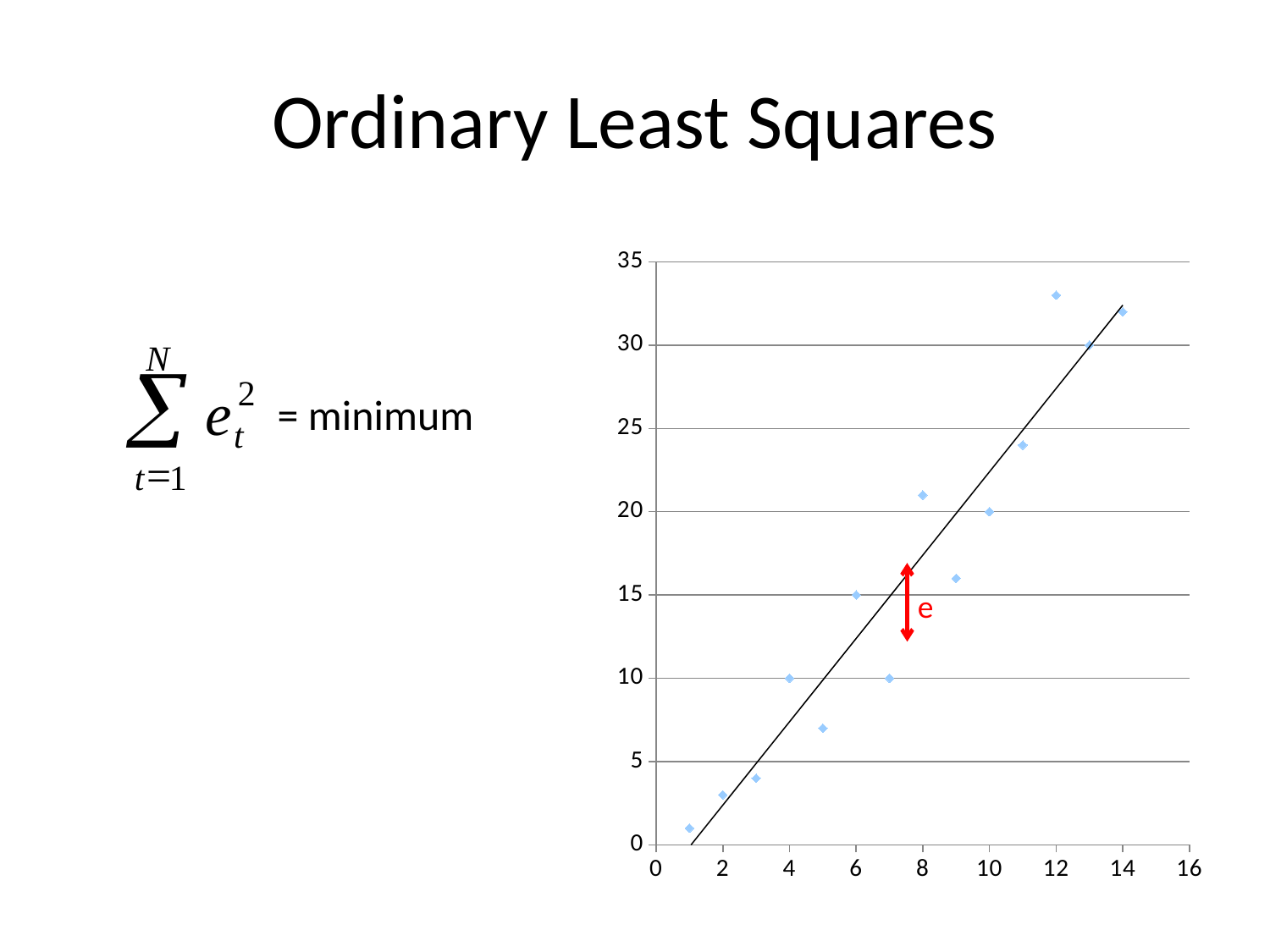
Is the y value of the point at x = 8 greater or less than 20? greater What kind of chart is shown on the slide? scatter chart What is the y value of the point at x = 10? 20 What is the y value of the point at x = 6? 15 What letter labels the red double-headed arrow on the chart? e Is the y value of the point at x = 5 greater or less than 10? less Which x value has the lowest plotted y value? 1 Which point has the larger y value, the one at x = 4 or the one at x = 5? x = 4 How many data points are plotted in the chart? 14 Do the plotted values generally rise or fall as x increases? rise What is the y value of the point at x = 13? 30 Is the y value of the point at x = 12 greater or less than 30? greater